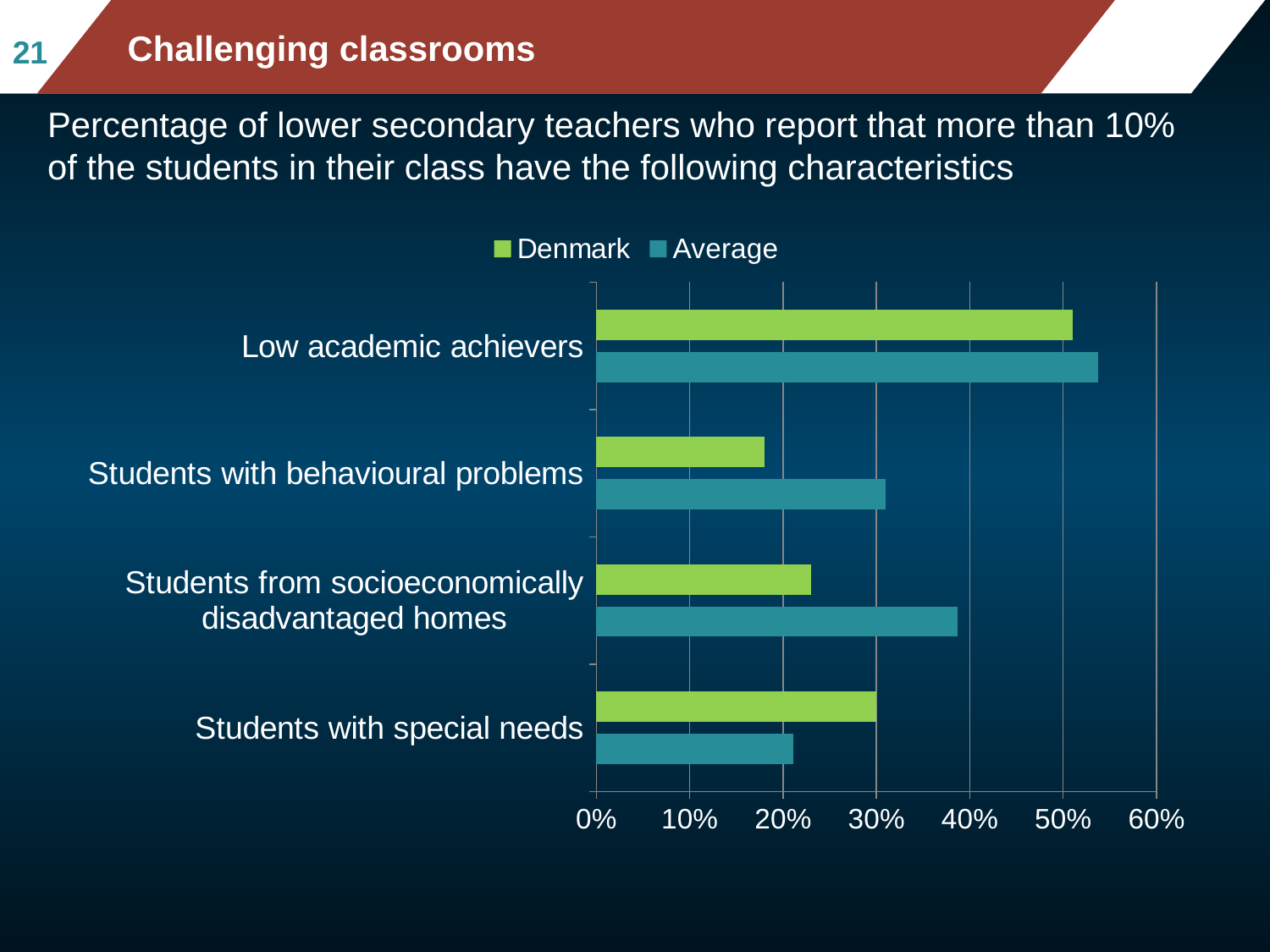
For Students with special needs, which is larger: Denmark or Average? Denmark Which series is shown in green in the legend? Denmark What kind of chart is shown on the slide? Bar chart Is the Denmark value for Students with behavioural problems greater or less than 20%? less Which category has the highest value for the Average series? Low academic achievers Which category has the lowest value for the Denmark series? Students with behavioural problems How many categories are shown on the chart? 4 Is the Average value for Students from socioeconomically disadvantaged homes greater or less than 30%? greater Is the Average value for Low academic achievers greater or less than 50%? greater For Students with behavioural problems, which is larger: Denmark or Average? Average How many series does the legend list? 2